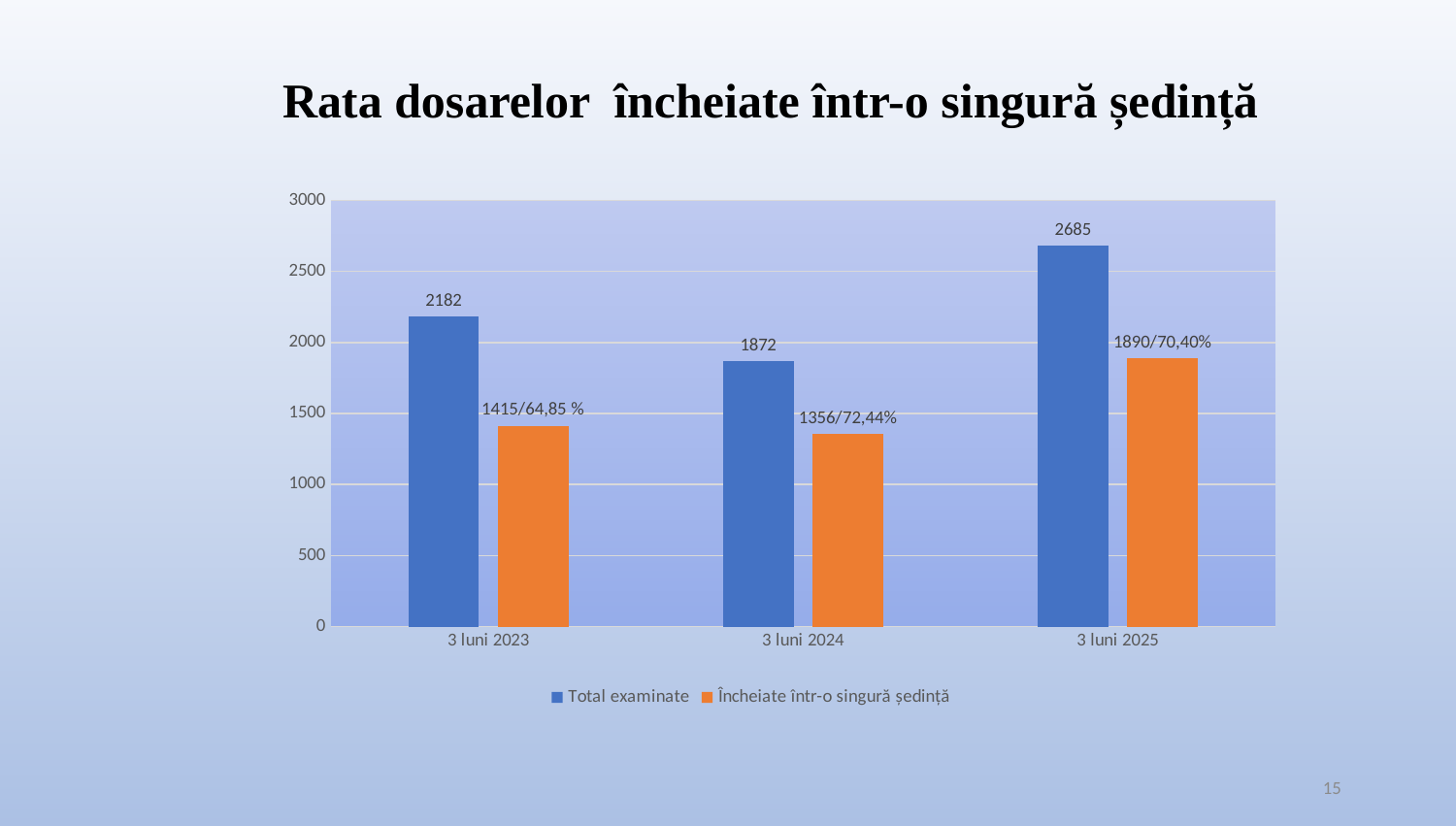
How many categories are shown on the x axis? 3 Which category has the highest Total examinate value? 3 luni 2025 How many series does the legend list? 2 What is the difference between Total examinate for 3 luni 2025 and 3 luni 2023? 503 Is the Total examinate value for 3 luni 2025 greater or less than 2500? greater What is the data label on the Încheiate într-o singură ședință bar for 3 luni 2024? 1356/72,44% What is the value of Total examinate for 3 luni 2023? 2182 What is the value of Total examinate for 3 luni 2024? 1872 Which category has the lowest Total examinate value? 3 luni 2024 What is the data label on the Încheiate într-o singură ședință bar for 3 luni 2025? 1890/70,40% What kind of chart is shown on the slide? bar chart Which is larger: Total examinate for 3 luni 2023 or for 3 luni 2024? 3 luni 2023